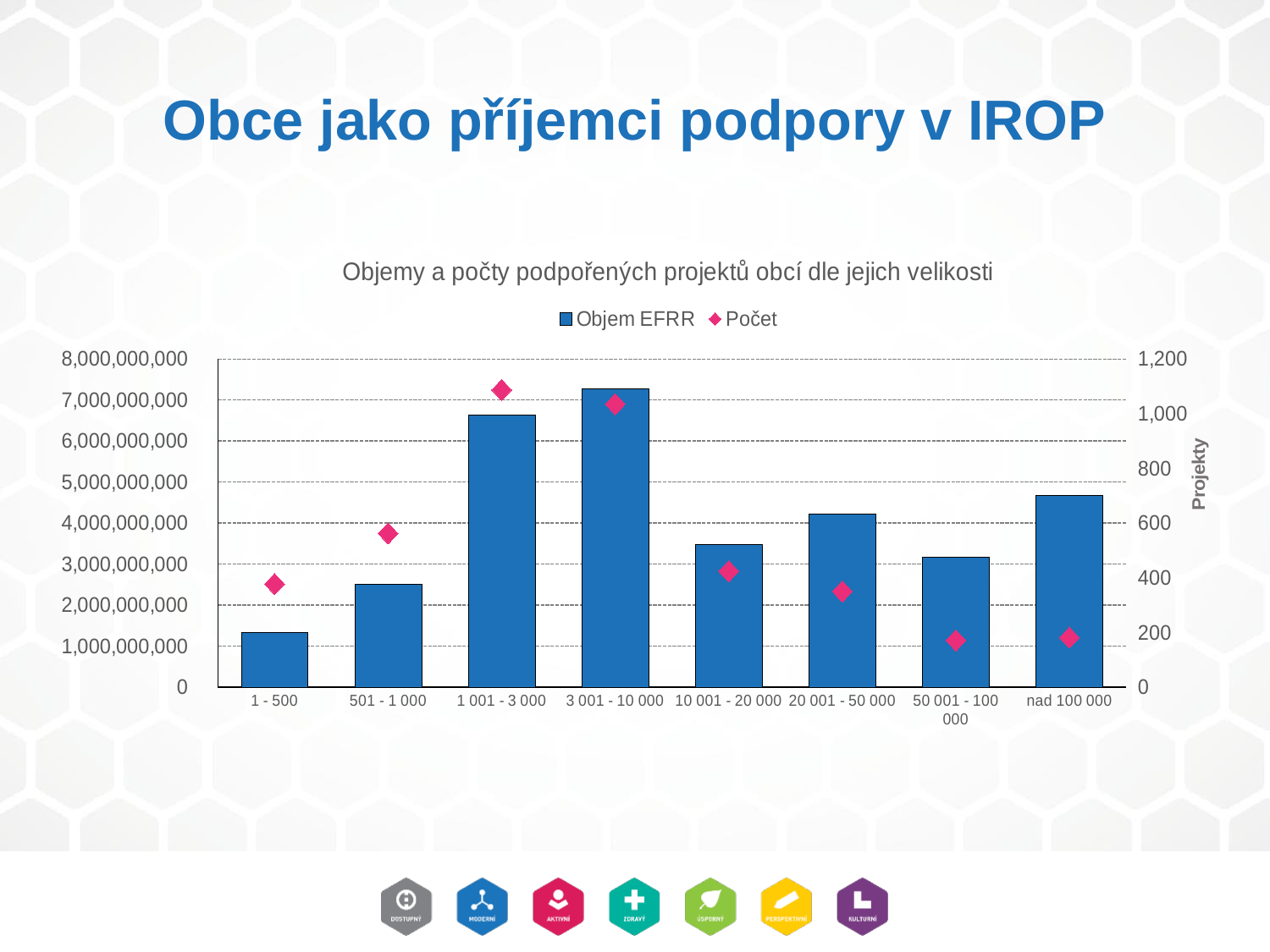
Is the Počet value for 50 001 - 100 000 greater or less than 200? less What is the label of the right-hand vertical axis? Projekty Which category has the lowest Objem EFRR bar? 1 - 500 Which has the larger Objem EFRR bar: 20 001 - 50 000 or 10 001 - 20 000? 20 001 - 50 000 What is the title of the chart? Objemy a počty podpořených projektů obcí dle jejich velikosti Is the Objem EFRR value for 1 - 500 greater or less than 2,000,000,000? less How many municipality size categories are shown on the x axis? 8 Which category has the highest Objem EFRR bar? 3 001 - 10 000 Is the Objem EFRR value for 1 001 - 3 000 greater or less than 6,000,000,000? greater Which series is shown with pink diamond markers? Počet How many series does the chart legend list? 2